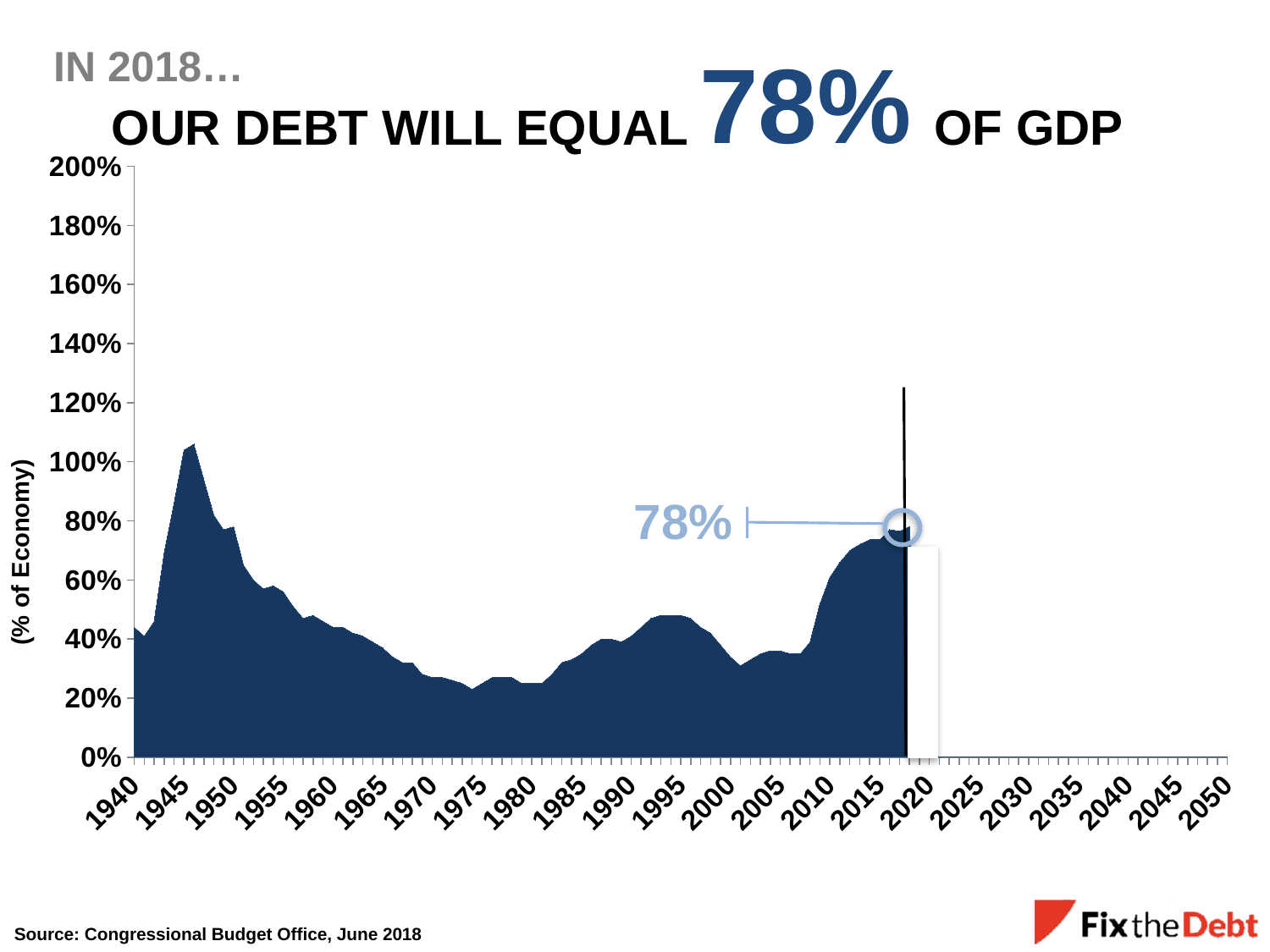
Is the peak value reached in the 1940s greater or less than 100%? greater Which year has the larger value, 1950 or 1990? 1950 Is the value for 1995 greater or less than 60%? less Is the value for 1940 greater or less than 60%? less Do the values rise or fall between 1950 and 1975? fall What kind of chart is shown on the slide? area chart Do the values rise or fall between 2010 and 2018? rise What is the highest value shown on the vertical axis? 200% What is the debt as a percentage of GDP shown for 2018? 78% In which decade does the chart reach its highest value? 1940s What is the label on the vertical axis? (% of Economy)